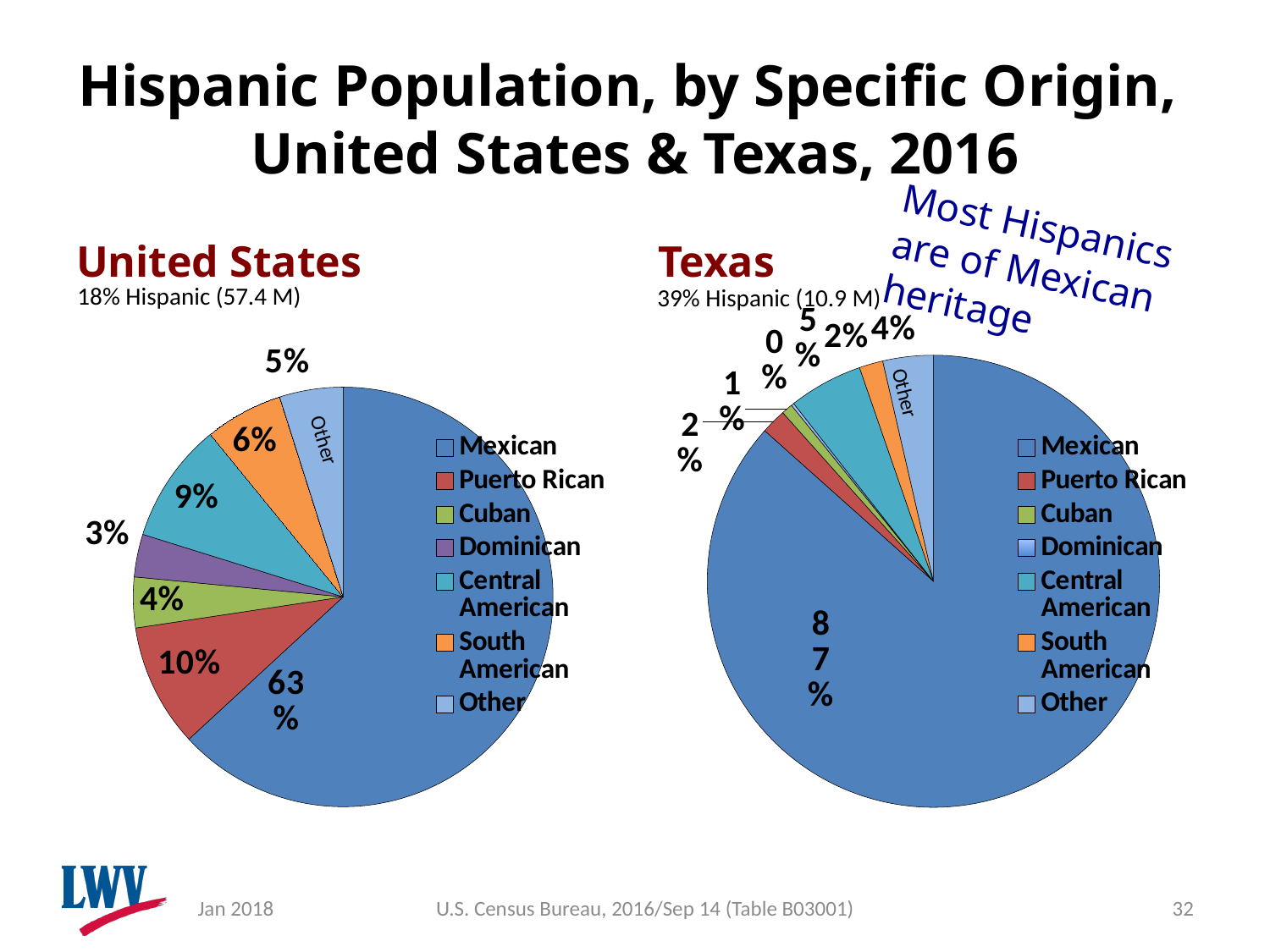
In the Texas pie chart, what percentage is Central American? 5% How many origin categories does the legend of the Texas pie chart list? 7 According to the text under the Texas chart title, what percentage of the Texas population is Hispanic? 39% In the United States pie chart, which origin group has the largest slice? Mexican In the United States pie chart, what share of the Hispanic population is Mexican? 63% What kind of chart is used for the United States data? Pie chart In the United States pie chart, what percentage is Puerto Rican? 10% What is the difference between the Mexican share in the Texas pie chart and the Mexican share in the United States pie chart? 24 percentage points In the United States pie chart, what percentage is Central American? 9% In the United States pie chart, which origin group has the smallest slice? Dominican In the United States pie chart, which is larger: the South American slice or the Cuban slice? South American In the Texas pie chart, what share of the Hispanic population is Mexican? 87%